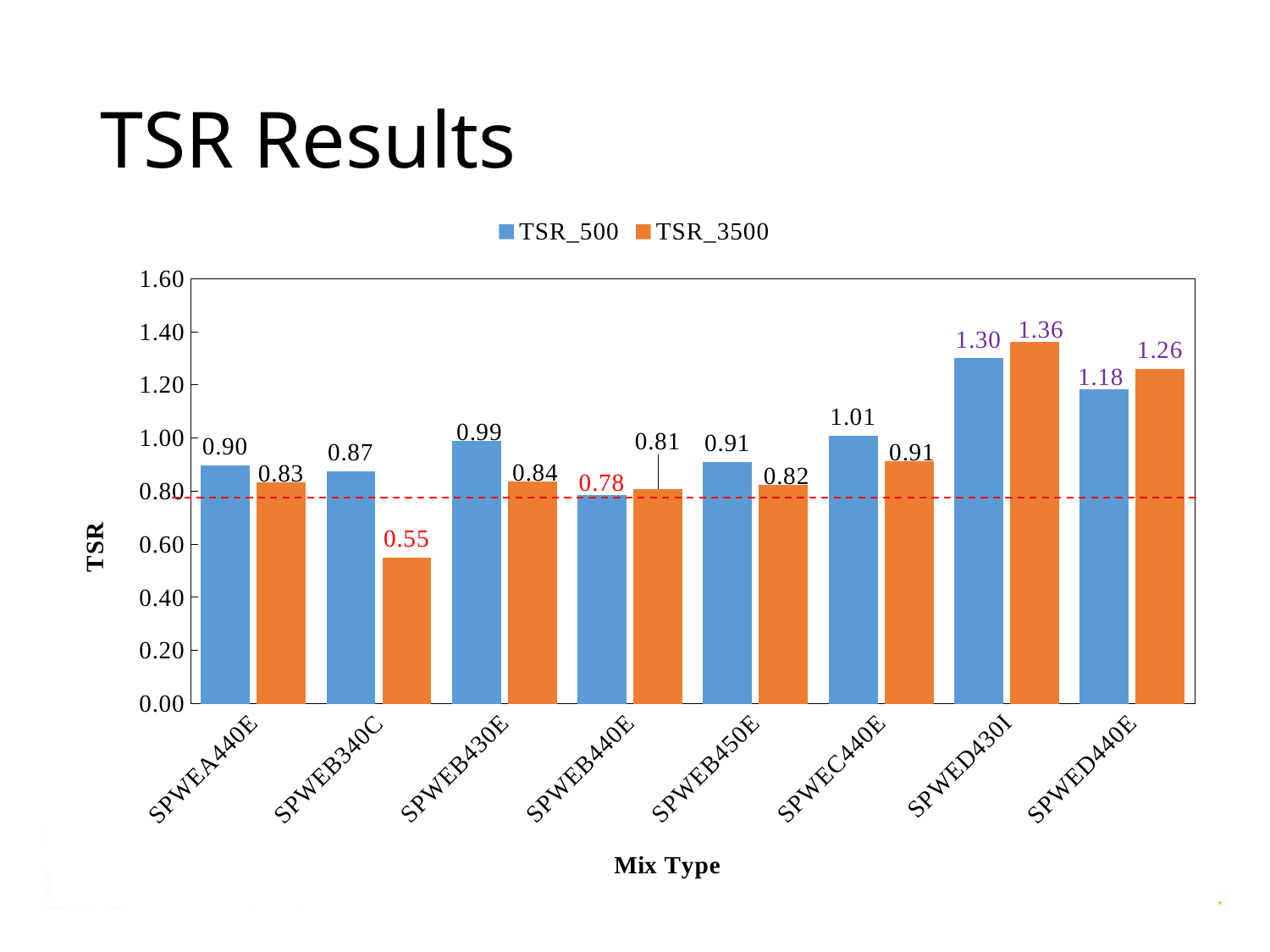
Which mix type has the highest TSR_500 value? SPWED430I What is the TSR_3500 value for SPWEB340C? 0.55 How many mix types are shown on the x axis? 8 Is the TSR_3500 value for SPWEC440E greater or less than 1.00? less What is the label of the x axis? Mix Type What is the difference between the TSR_500 and TSR_3500 values for SPWEB340C? 0.32 What is the TSR_500 value for SPWEB430E? 0.99 What is the TSR_3500 value for SPWED430I? 1.36 Which is larger for SPWED440E, TSR_500 or TSR_3500? TSR_3500 What kind of chart is shown on the slide? bar chart Which mix type has the lowest TSR_3500 value? SPWEB340C How many series does the legend list? 2